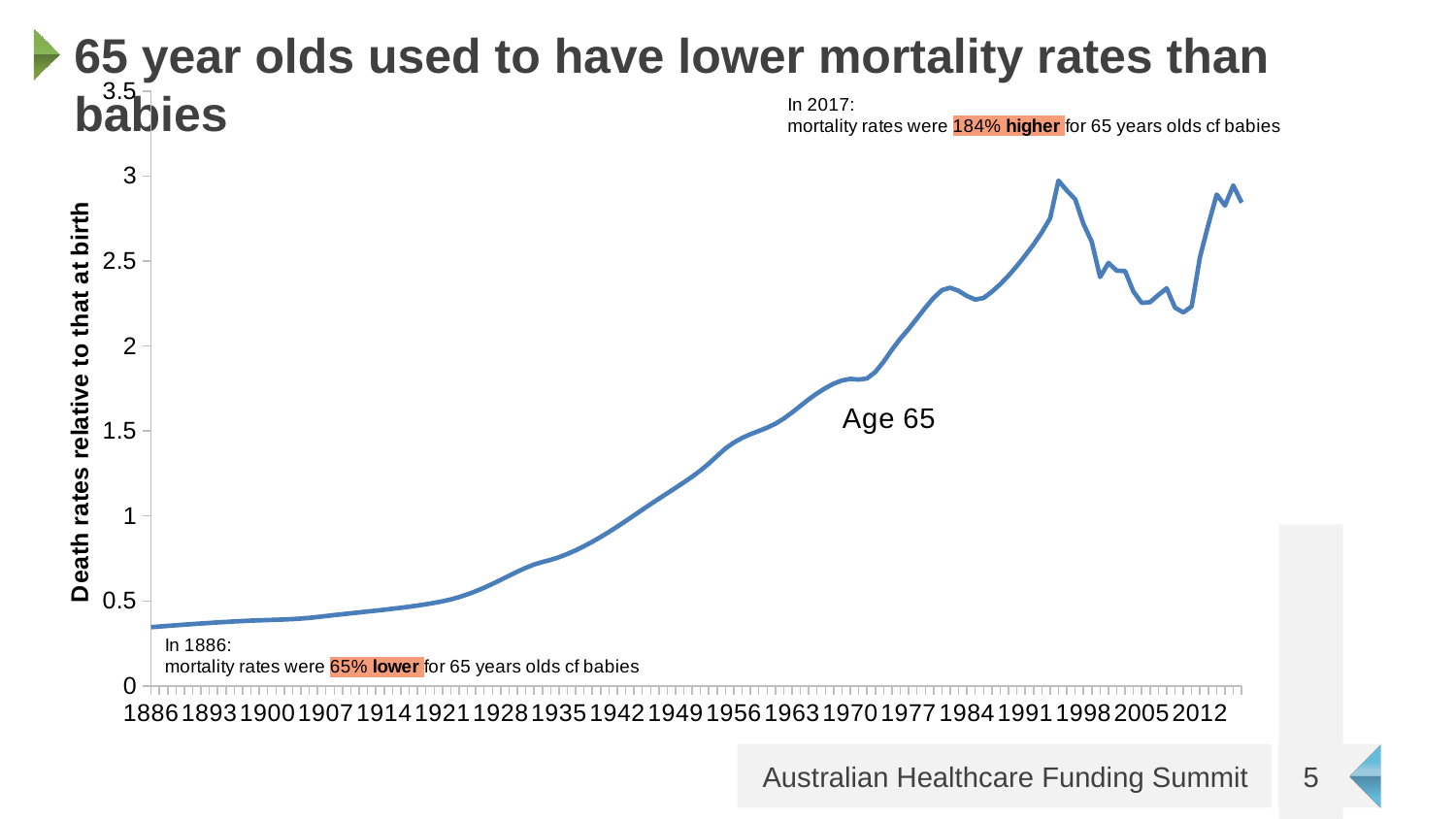
Which year has the larger value, 1921 or 1977? 1977 According to the annotation, by what percentage were mortality rates for 65 year olds lower than for babies in 1886? 65% lower What kind of chart is shown on the slide? line chart Is the value for 1963 greater or less than 1.5? greater According to the annotation, by what percentage were mortality rates for 65 year olds higher than for babies in 2017? 184% higher Overall, do the values rise or fall from 1886 to 2012 along the x axis? rise Is the value for 1998 greater or less than 2.5? greater Is the value for 1886 greater or less than 0.5? less What is the label on the y axis of the chart? Death rates relative to that at birth Which age group does the plotted line represent? Age 65